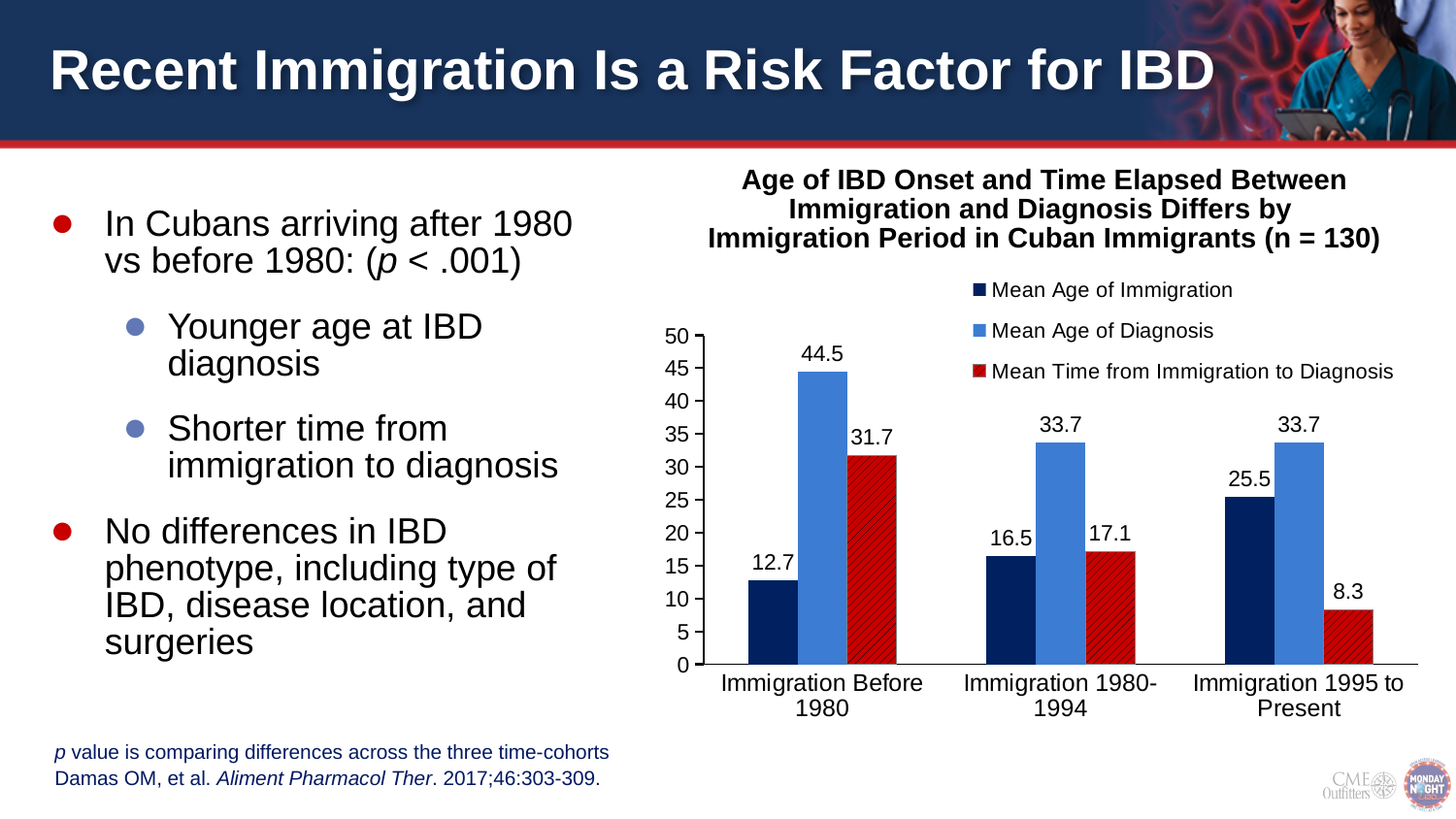
What is the Mean Age of Immigration for the Immigration 1995 to Present group? 25.5 How many series does the legend list? 3 How many immigration period categories are shown on the x axis? 3 What is the Mean Time from Immigration to Diagnosis for the Immigration 1980-1994 group? 17.1 What kind of chart is shown on the slide? Bar chart Is the Mean Age of Immigration for Immigration Before 1980 greater or less than 15? less What is the difference between the Mean Time from Immigration to Diagnosis for Immigration Before 1980 and for Immigration 1995 to Present? 23.4 What is the Mean Age of Diagnosis for the Immigration Before 1980 group? 44.5 Which is larger: the Mean Age of Immigration for Immigration 1980-1994 or for Immigration 1995 to Present? Immigration 1995 to Present Does the Mean Time from Immigration to Diagnosis rise or fall across the immigration periods from left to right? Fall Which immigration period has the lowest Mean Time from Immigration to Diagnosis? Immigration 1995 to Present Which immigration period has the highest Mean Age of Diagnosis? Immigration Before 1980